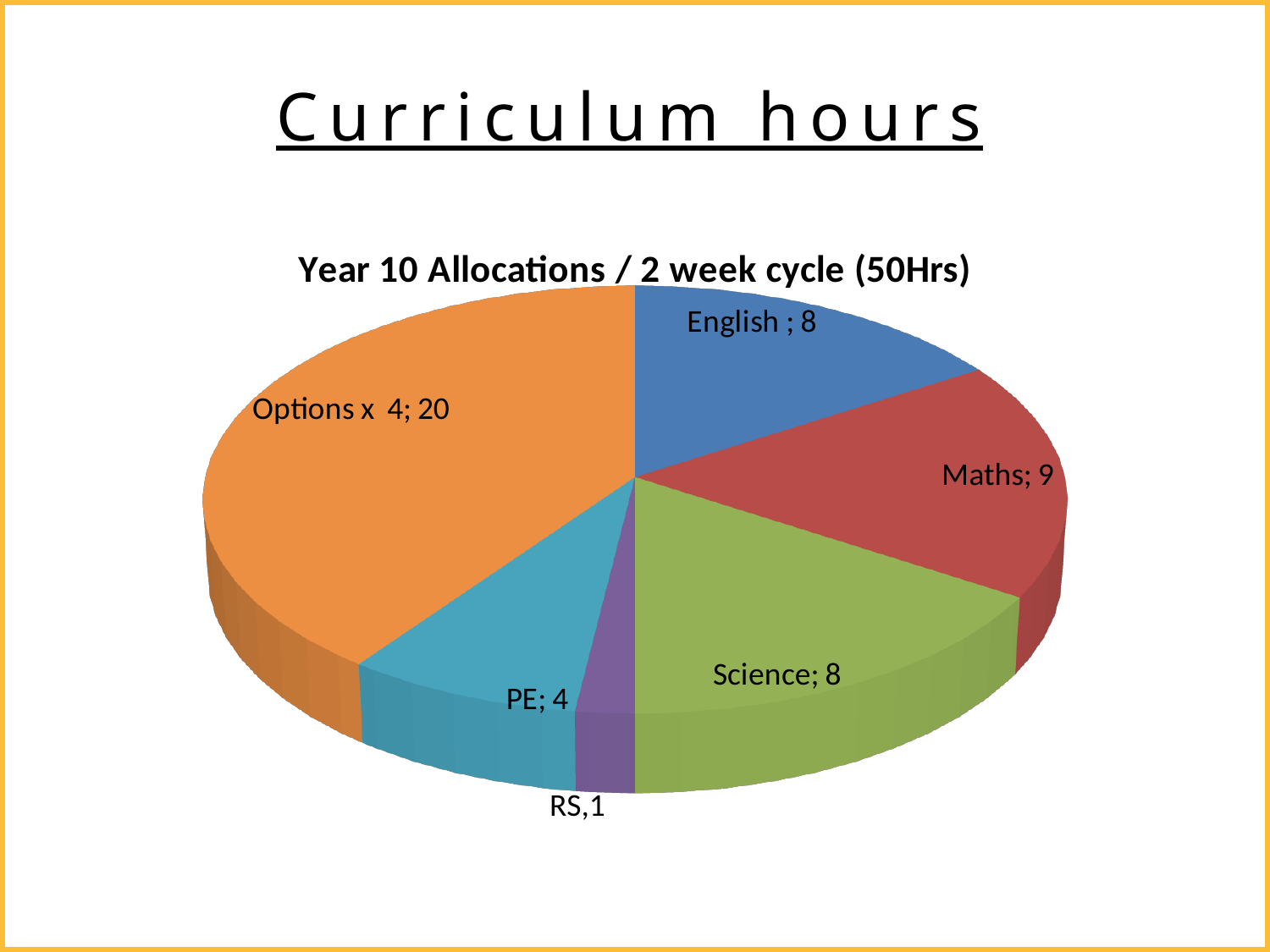
Which category has the smallest slice of the pie? RS How many hours are allocated to Maths? 9 How many hours are allocated to Options x 4? 20 How many slices does the pie chart have? 6 Which category has the largest slice of the pie? Options x 4 How many hours are allocated to PE? 4 What colour is the Science slice? Green What type of chart is shown on the slide? Pie chart Which is allocated more hours, Maths or PE? Maths What is the difference in hours between Options x 4 and Maths? 11 What share of the total hours does Options x 4 represent? 40% What is the title of the chart? Year 10 Allocations / 2 week cycle (50Hrs)